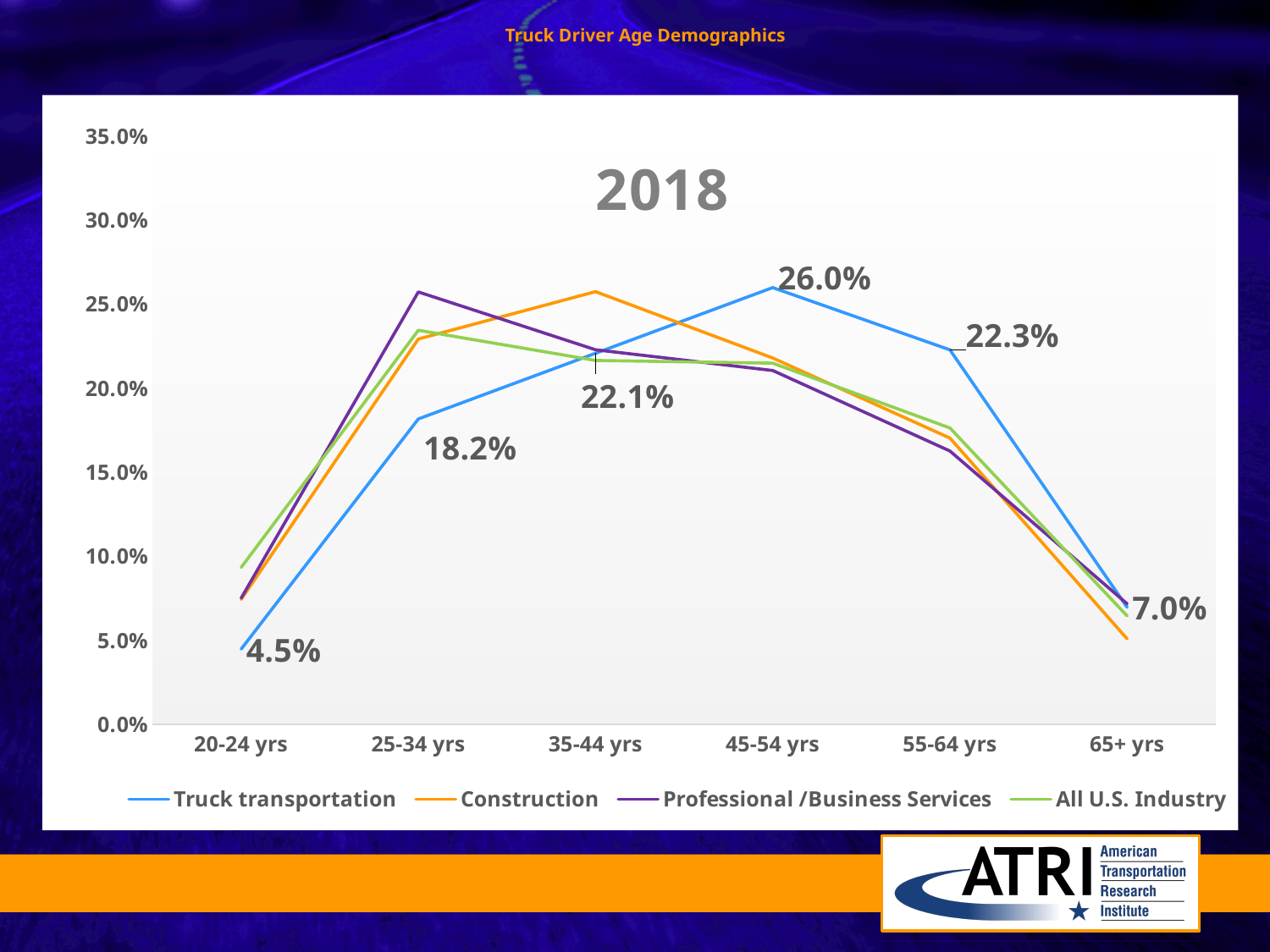
What is the value for Truck transportation in the 65+ yrs age group? 7.0% How many age groups are shown on the x axis? 6 How many series does the legend list? 4 What is the value for Truck transportation in the 35-44 yrs age group? 22.1% What is the value for Truck transportation in the 20-24 yrs age group? 4.5% For Truck transportation, which is larger: the value for 25-34 yrs or the value for 55-64 yrs? 55-64 yrs What is the difference between the Truck transportation values for 45-54 yrs and 55-64 yrs? 3.7 percentage points What is the value for Truck transportation in the 45-54 yrs age group? 26.0% Which age group has the lowest value for Truck transportation? 20-24 yrs What kind of chart is shown on the slide? Line chart Is the value for Construction in the 65+ yrs age group greater or less than 10.0%? less Which age group has the highest value for Truck transportation? 45-54 yrs